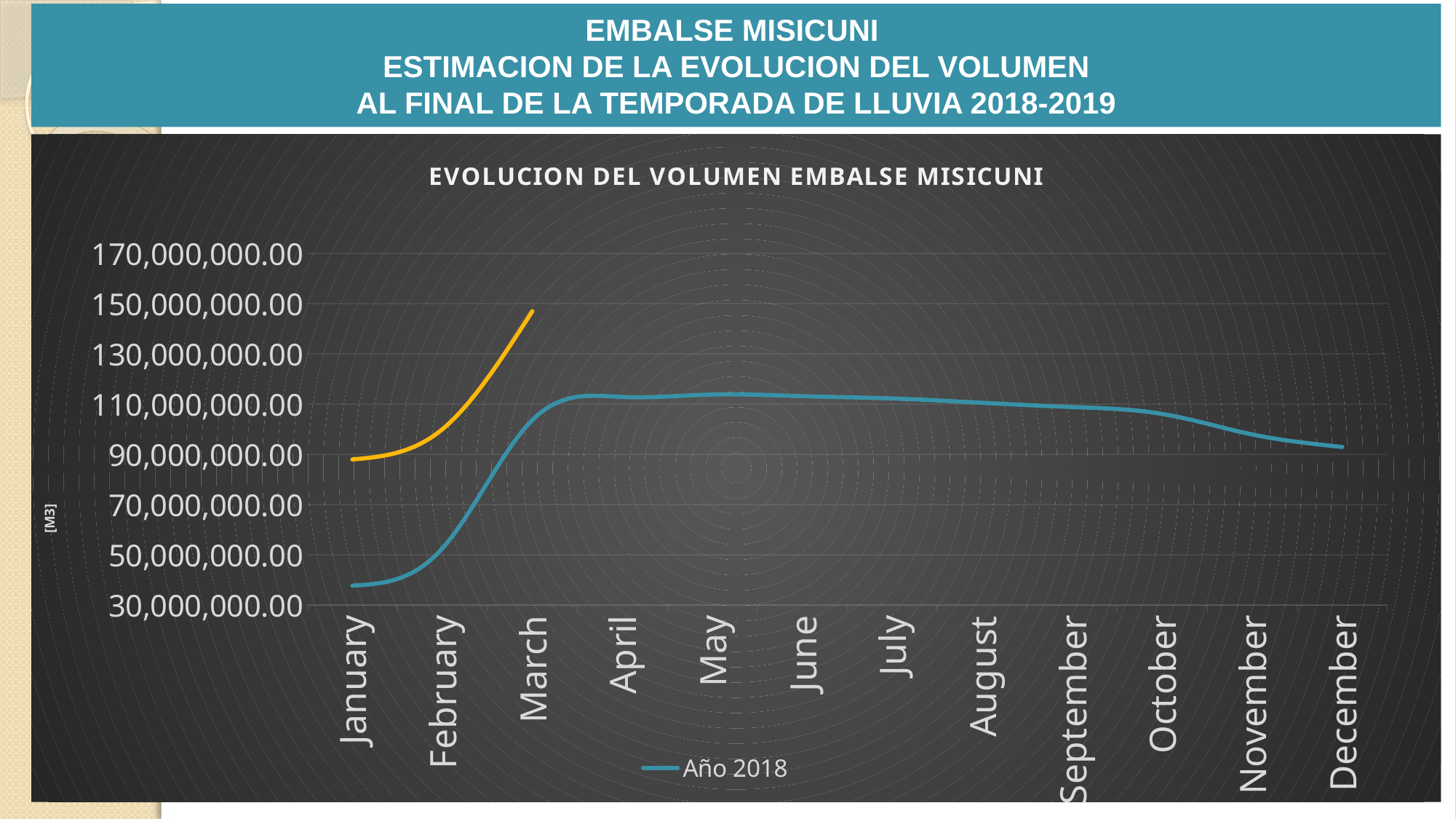
Is the Año 2018 value for November greater or less than 110,000,000.00? less What is the title of the chart? EVOLUCION DEL VOLUMEN EMBALSE MISICUNI What series name appears in the chart legend? Año 2018 How many months are shown along the x axis of the chart? 12 In which month is the Año 2018 line at its lowest value? January Does the Año 2018 line rise or fall from January to May? rise Is the Año 2018 value for July greater or less than 90,000,000.00? greater What kind of chart is shown on the slide? line chart Is the Año 2018 value for January greater or less than 50,000,000.00? less In March, which line has the larger value, the orange line or the Año 2018 line? the orange line How many series does the chart legend list? 1